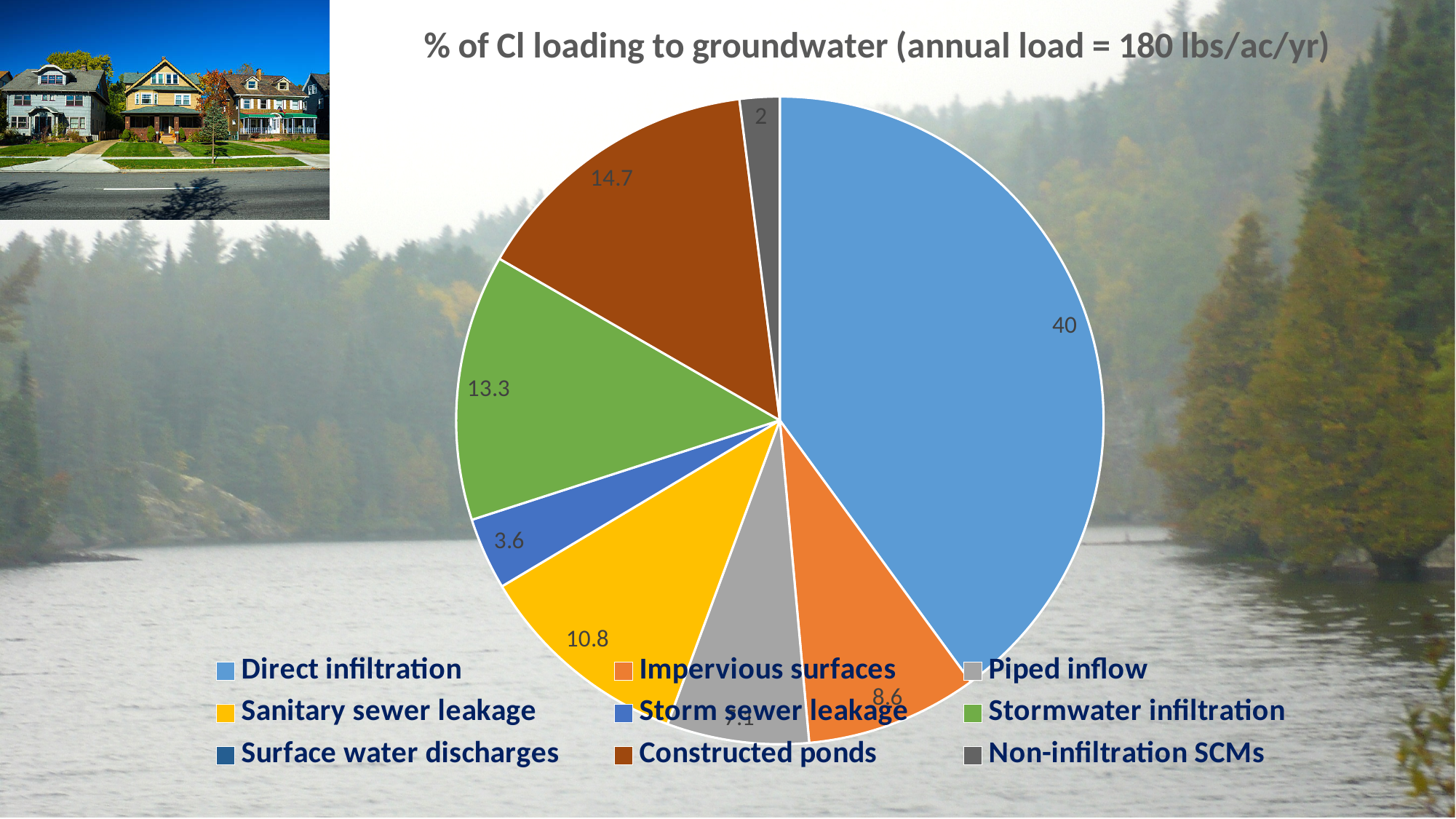
What value is shown for Storm sewer leakage? 3.6 What value is shown for Constructed ponds? 14.7 Which category accounts for the largest share of Cl loading to groundwater? Direct infiltration What percentage of Cl loading to groundwater comes from Direct infiltration? 40 What value is shown for Stormwater infiltration? 13.3 What value is shown for Sanitary sewer leakage? 10.8 What kind of chart is shown on the slide? pie chart How many categories does the legend list? 9 What value is shown for Impervious surfaces? 8.6 What value is shown for Non-infiltration SCMs? 2 Which is larger, the share for Constructed ponds or for Stormwater infiltration? Constructed ponds What is the difference between the Direct infiltration value and the Constructed ponds value? 25.3